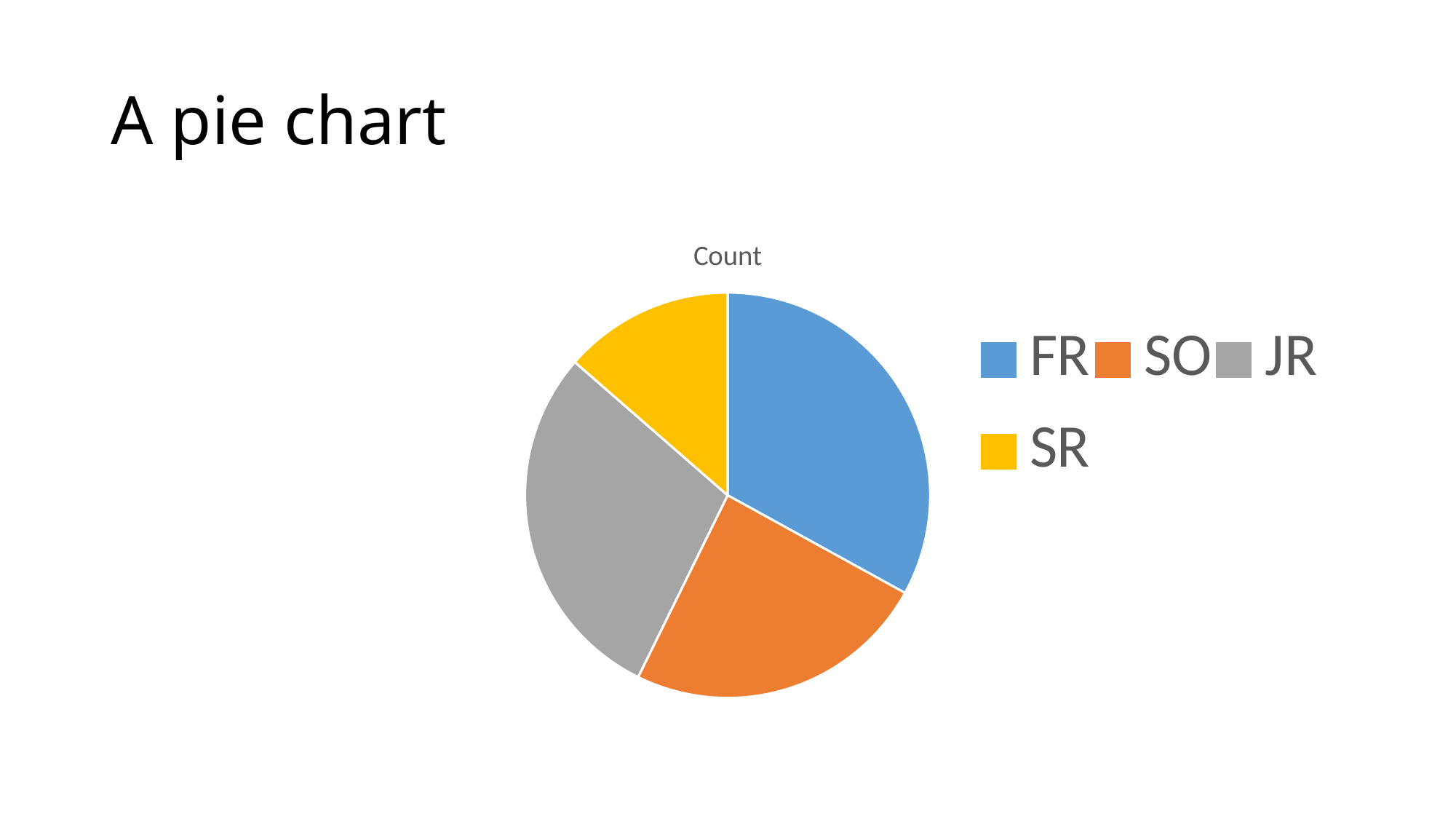
Which slice is larger in the pie chart, SO or SR? SO Which slice is larger in the pie chart, FR or SR? FR What is the title of the pie chart? Count Which category has the smallest slice in the pie chart? SR How many slices does the pie chart have? 4 Which slice is larger in the pie chart, JR or SR? JR How many entries does the legend of the pie chart list? 4 What kind of chart is shown on the slide? pie chart Which colour represents SR in the pie chart? yellow